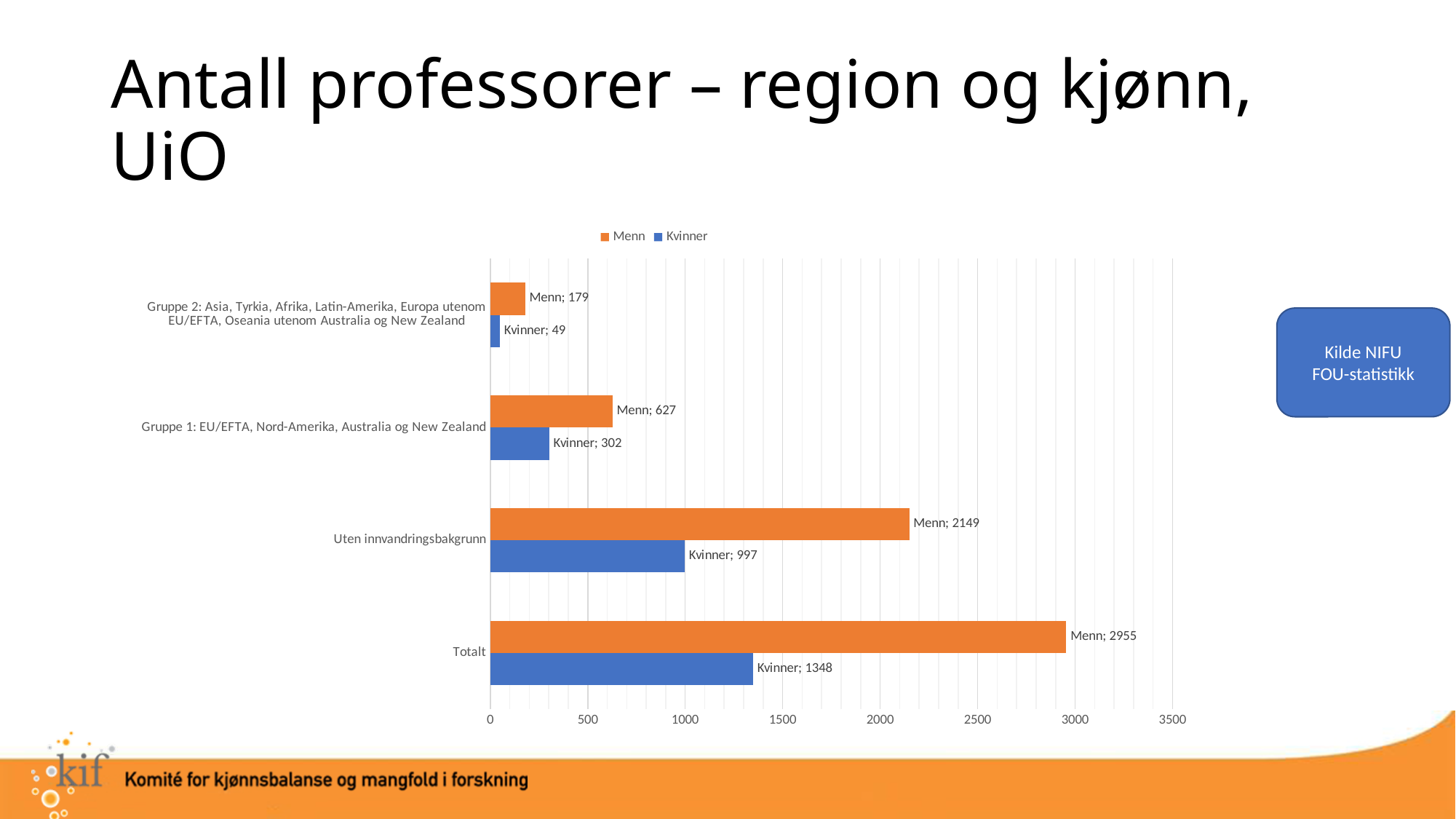
Which category has the highest value for Menn? Totalt How many categories are shown on the chart? 4 What is the difference between Menn and Kvinner in the Totalt category? 1607 What is the value for Kvinner in the Uten innvandringsbakgrunn category? 997 What kind of chart is shown on the slide? Bar chart How many series does the legend list? 2 Which is larger: Kvinner in Uten innvandringsbakgrunn or Menn in Gruppe 1? Kvinner in Uten innvandringsbakgrunn What is the difference between Menn and Kvinner in Gruppe 1? 325 What is the value for Menn in the Totalt category? 2955 What is the value for Menn in Gruppe 1? 627 What is the value for Kvinner in Gruppe 2? 49 Which category has the lowest value for Kvinner? Gruppe 2